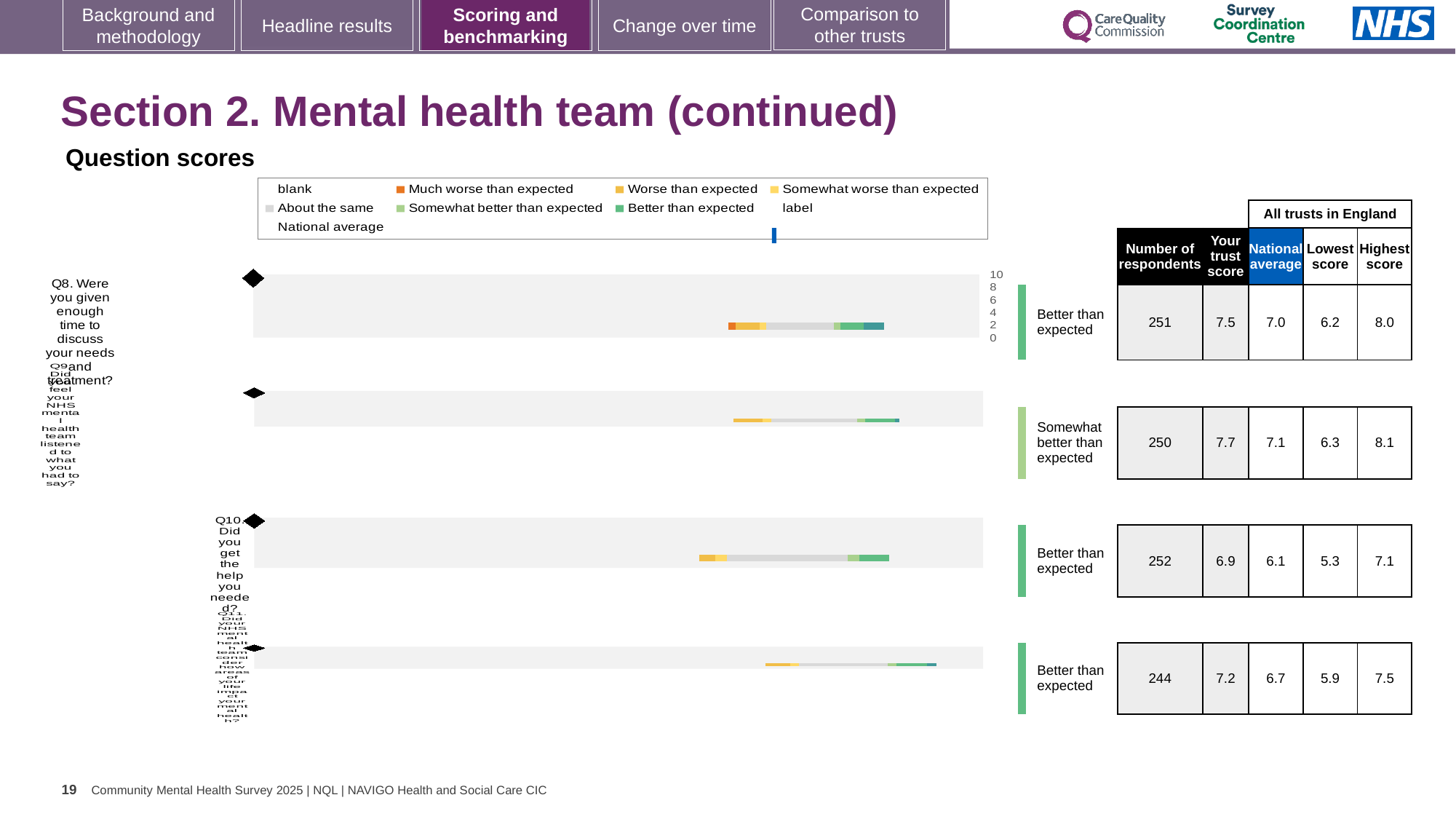
What colour is the 'Much worse than expected' legend entry? orange For Q8, what is the National average score? 7.0 What kind of chart is used to show the question scores on this slide? bar chart How many legend entries describe how a score compares to expected (from 'Much worse than expected' to 'Better than expected')? 6 What is the benchmark category shown for Q9? Somewhat better than expected For Q10 (Did you get the help you needed?), is the trust score or the National average larger? Your trust score For Q8, what is the difference between the Highest score and the Lowest score across all trusts in England? 1.8 Which question row has the highest 'Your trust score'? Q9 For Q11, what is the difference between the trust score and the National average? 0.5 For Q8, how many respondents are there? 251 Which question row has the lowest 'Your trust score'? Q10 For Q8 (Were you given enough time to discuss your needs and treatment?), what is the 'Your trust score'? 7.5